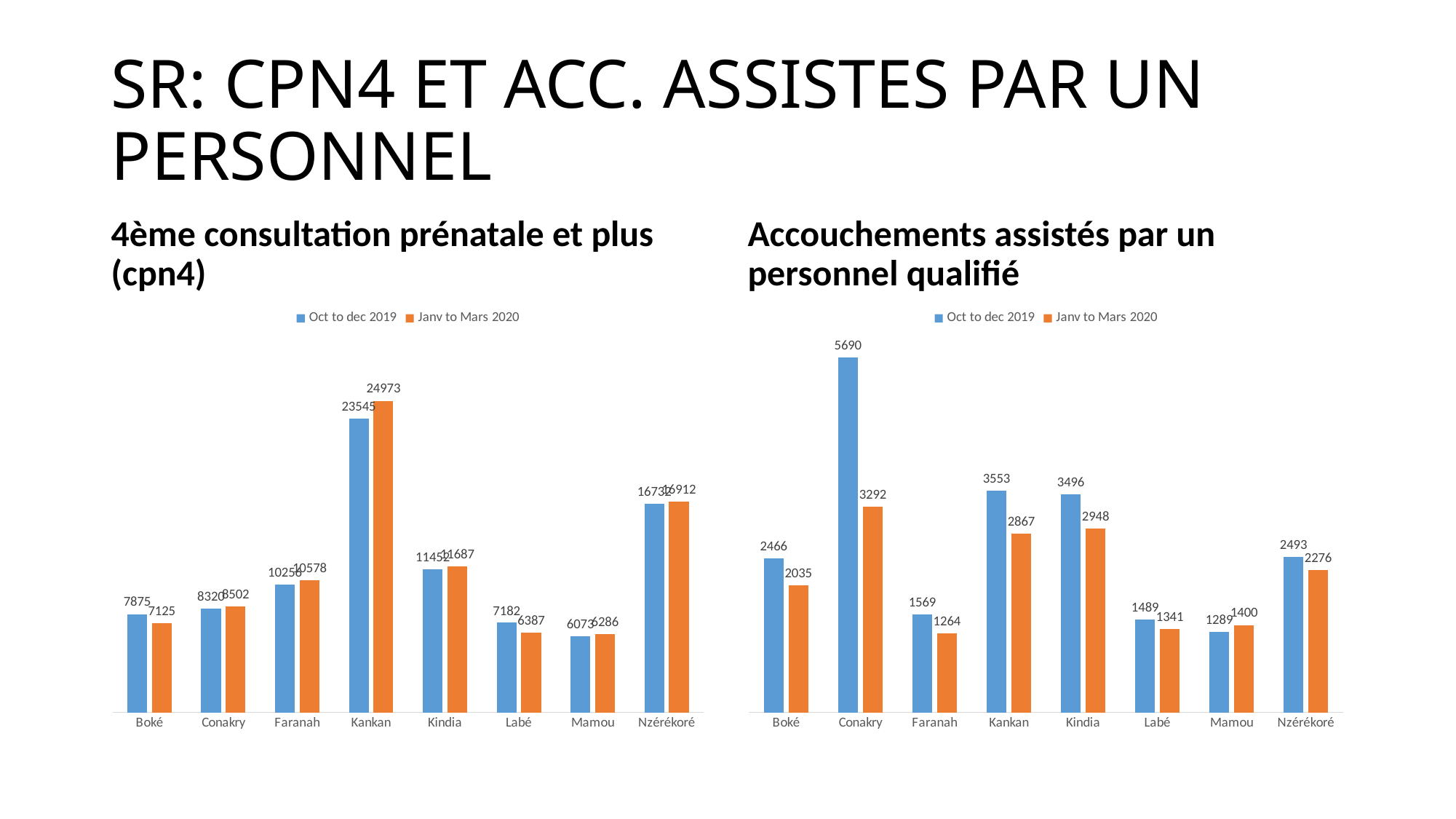
In the chart titled "Accouchements assistés par un personnel qualifié", which category has the lowest value in the Janv to Mars 2020 series? Faranah In the chart titled "Accouchements assistés par un personnel qualifié", what is the value for Mamou in the Janv to Mars 2020 series? 1400 In the chart titled "Accouchements assistés par un personnel qualifié", what is the difference between the Oct to dec 2019 and Janv to Mars 2020 values for Conakry? 2398 In the chart titled "4ème consultation prénatale et plus (cpn4)", which category has the highest value in the Janv to Mars 2020 series? Kankan How many series does the legend list in the chart titled "Accouchements assistés par un personnel qualifié"? 2 In the chart titled "4ème consultation prénatale et plus (cpn4)", what is the difference between the Oct to dec 2019 and Janv to Mars 2020 values for Boké? 750 What kind of chart is the chart titled "4ème consultation prénatale et plus (cpn4)"? Bar chart In the chart titled "Accouchements assistés par un personnel qualifié", what is the value for Conakry in the Oct to dec 2019 series? 5690 In the chart titled "4ème consultation prénatale et plus (cpn4)", how many categories are shown on the x axis? 8 In the chart titled "Accouchements assistés par un personnel qualifié", which is larger for Kankan: the Oct to dec 2019 value or the Janv to Mars 2020 value? Oct to dec 2019 In the chart titled "4ème consultation prénatale et plus (cpn4)", what is the value for Kankan in the Oct to dec 2019 series? 23545 In the chart titled "4ème consultation prénatale et plus (cpn4)", what is the value for Labé in the Janv to Mars 2020 series? 6387